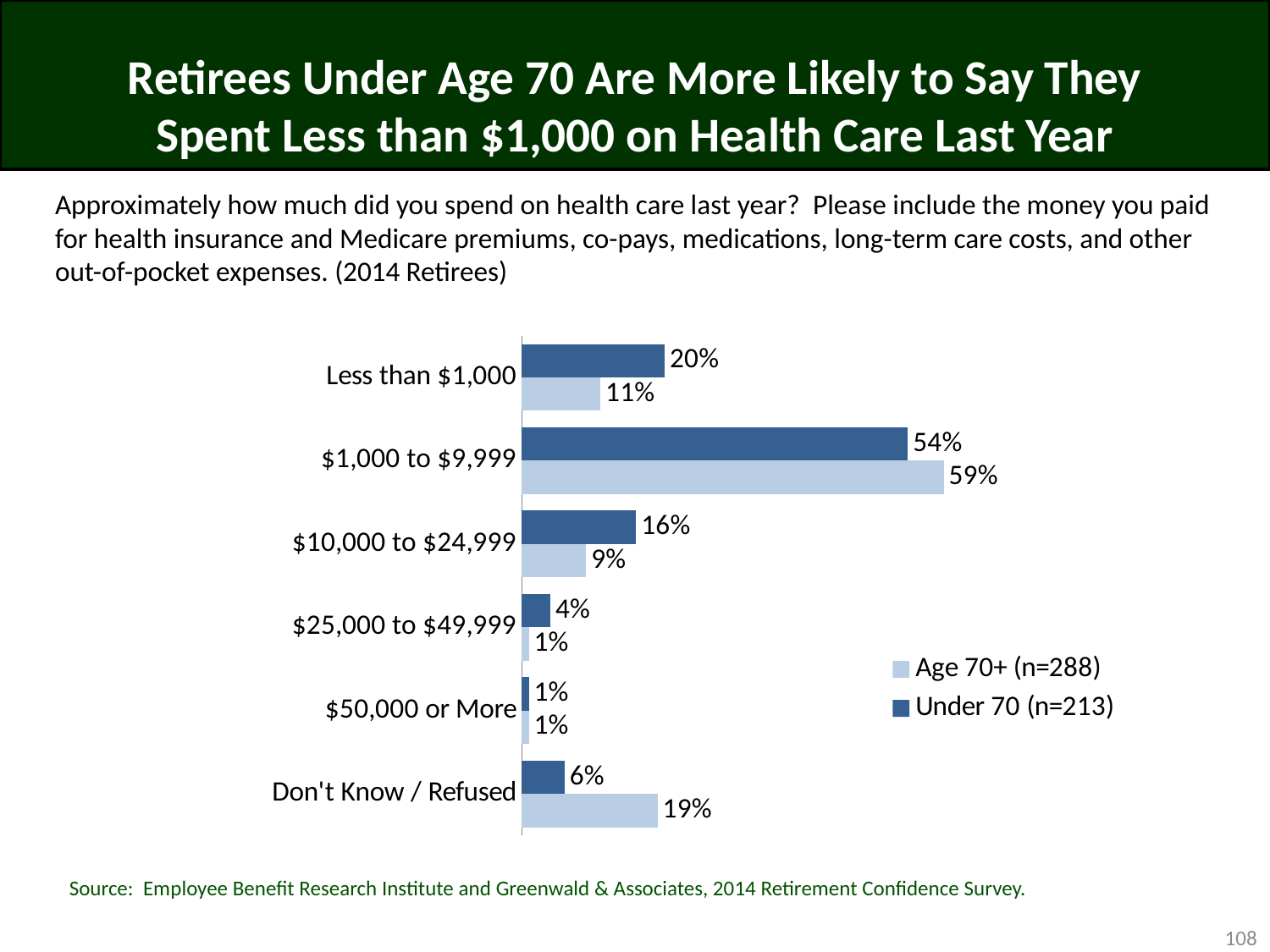
Which spending category has the lowest value for the Age 70+ group? $25,000 to $49,999 and $50,000 or More (both 1%) How many spending categories are shown on the chart? 6 What percentage of retirees age 70+ answered Don't Know / Refused? 19% For the $1,000 to $9,999 category, which group has the larger value, Under 70 or Age 70+? Age 70+ What is the difference between the Under 70 and Age 70+ values for $10,000 to $24,999? 7 percentage points What percentage of retirees age 70+ said they spent $1,000 to $9,999? 59% Which spending category has the highest value for the Under 70 group? $1,000 to $9,999 How many series does the legend list? 2 Which series is shown in the darker blue colour? Under 70 (n=213) What percentage of retirees under 70 said they spent less than $1,000 on health care last year? 20% What type of chart is shown on the slide? Bar chart What is the sample size for the Age 70+ group shown in the legend? n=288